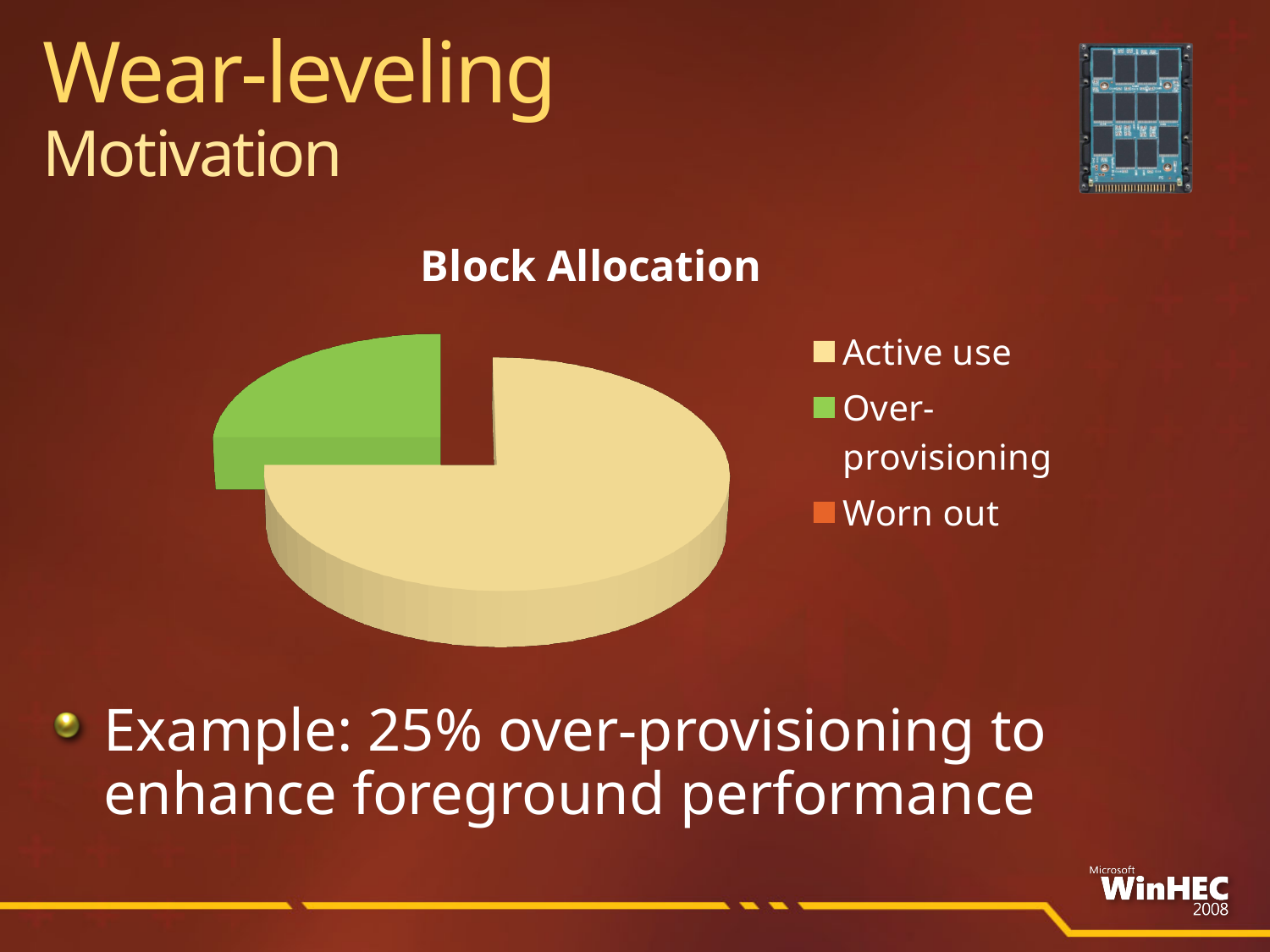
Which legend entry of the Block Allocation chart is shown in orange? Worn out Which category takes up the largest share of the Block Allocation pie? Active use How many categories does the legend of the Block Allocation chart list? 3 Is the Over-provisioning slice of the Block Allocation pie greater or less than half of the pie? less What colour represents Over-provisioning in the Block Allocation chart? Green What kind of chart is shown on the slide? Pie chart Which is larger in the Block Allocation pie, Active use or Over-provisioning? Active use What is the title of the pie chart? Block Allocation Is the Active use slice of the Block Allocation pie greater or less than half of the pie? greater